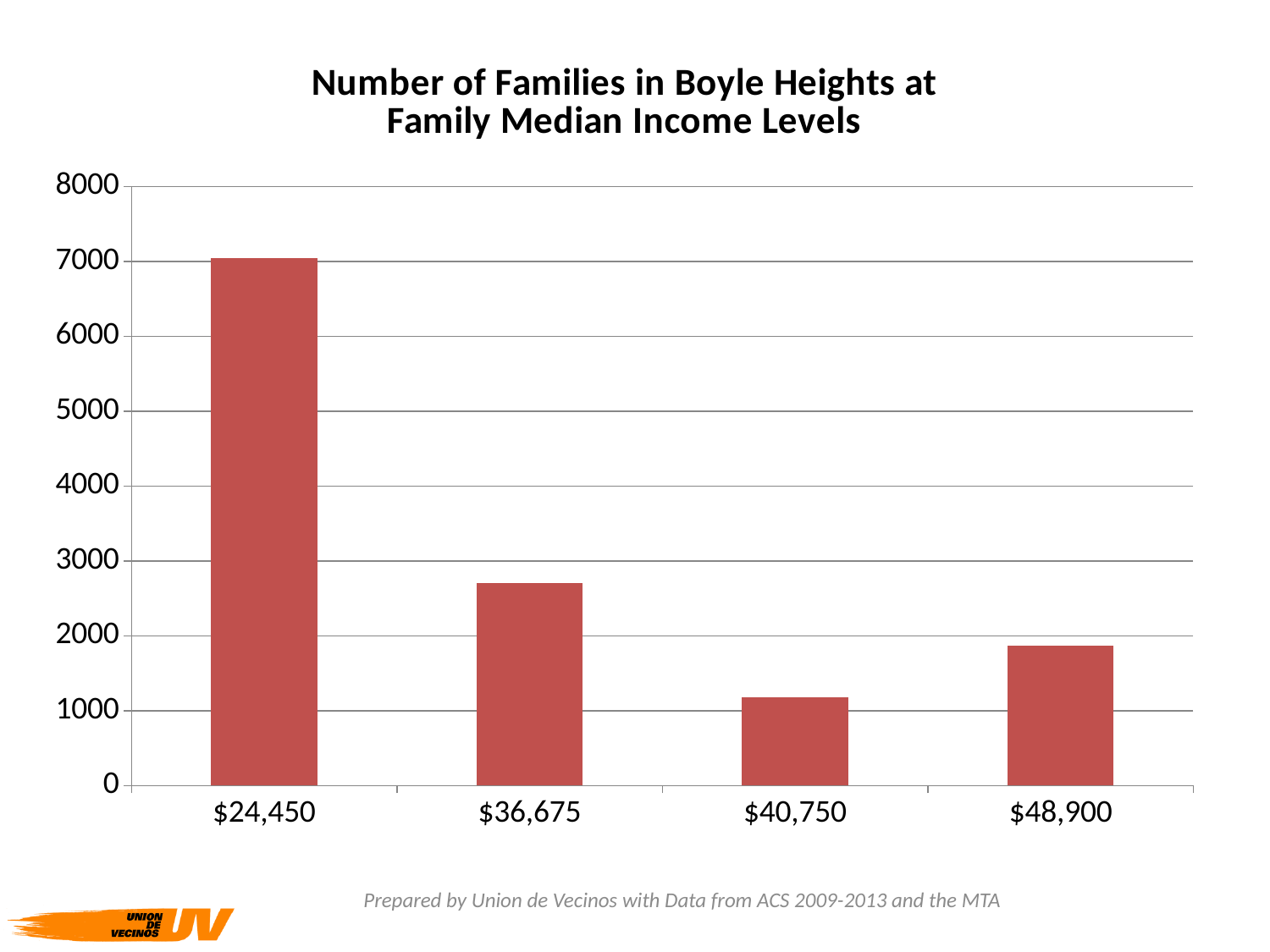
Is the value for $48,900 greater or less than 2000? less Which income level has the highest number of families? $24,450 What kind of chart is shown on the slide? bar chart Is the value for $36,675 greater or less than 3000? less What is the highest value shown on the y axis? 8000 Which income level has the lowest number of families? $40,750 How many income level categories are shown on the x axis? 4 Is the value for $40,750 greater or less than 1000? greater Which has more families, $36,675 or $48,900? $36,675 What is the title of the chart? Number of Families in Boyle Heights at Family Median Income Levels Which has more families, $40,750 or $48,900? $48,900